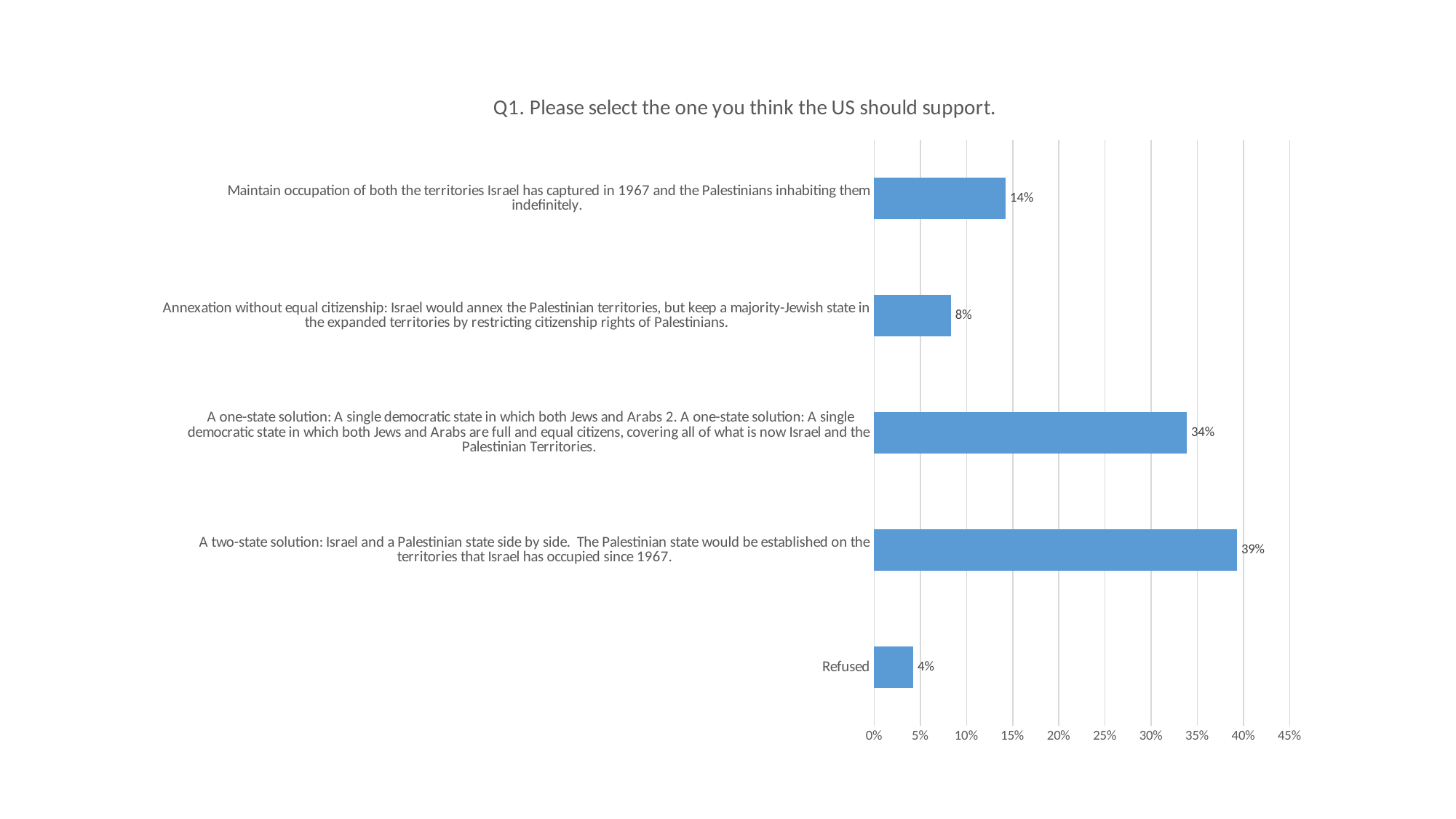
How many categories are shown on the chart? 5 What is the difference between the two-state solution and the one-state solution percentages? 5% What type of chart is shown on the slide? Bar chart What percentage of respondents refused to answer? 4% What percentage of respondents selected 'Annexation without equal citizenship'? 8% Which is larger: the value for 'Maintain occupation' or the value for 'Annexation without equal citizenship'? Maintain occupation What percentage of respondents selected the one-state solution? 34% What is the title of the chart? Q1. Please select the one you think the US should support. What percentage of respondents selected 'Maintain occupation' indefinitely? 14% What percentage of respondents selected the two-state solution? 39% Which option received the highest share of support? A two-state solution Which category has the lowest value on the chart? Refused